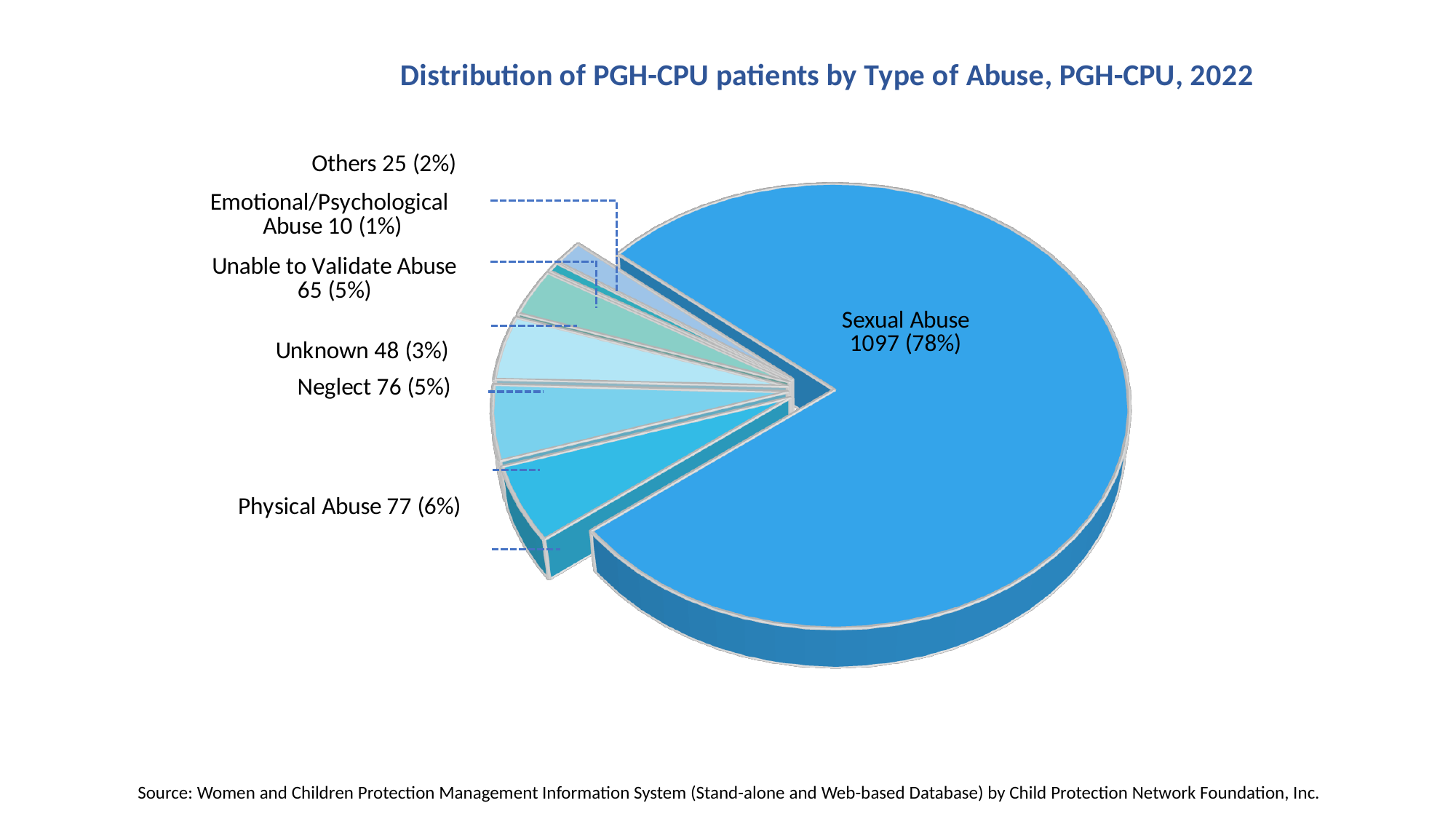
What is the title of the chart? Distribution of PGH-CPU patients by Type of Abuse, PGH-CPU, 2022 What is the difference in patient count between Physical Abuse and Neglect? 1 What percentage of patients does Physical Abuse account for? 6% Which type of abuse has the smallest number of patients? Emotional/Psychological Abuse What share of patients does Sexual Abuse represent? 78% Which type of abuse has the largest number of patients? Sexual Abuse How many patients are in the Others category? 25 Which has more patients, Unable to Validate Abuse or Unknown? Unable to Validate Abuse How many patients are in the Sexual Abuse category? 1097 How many categories does the pie chart show? 7 How many patients are in the Neglect category? 76 What kind of chart is shown on the slide? pie chart